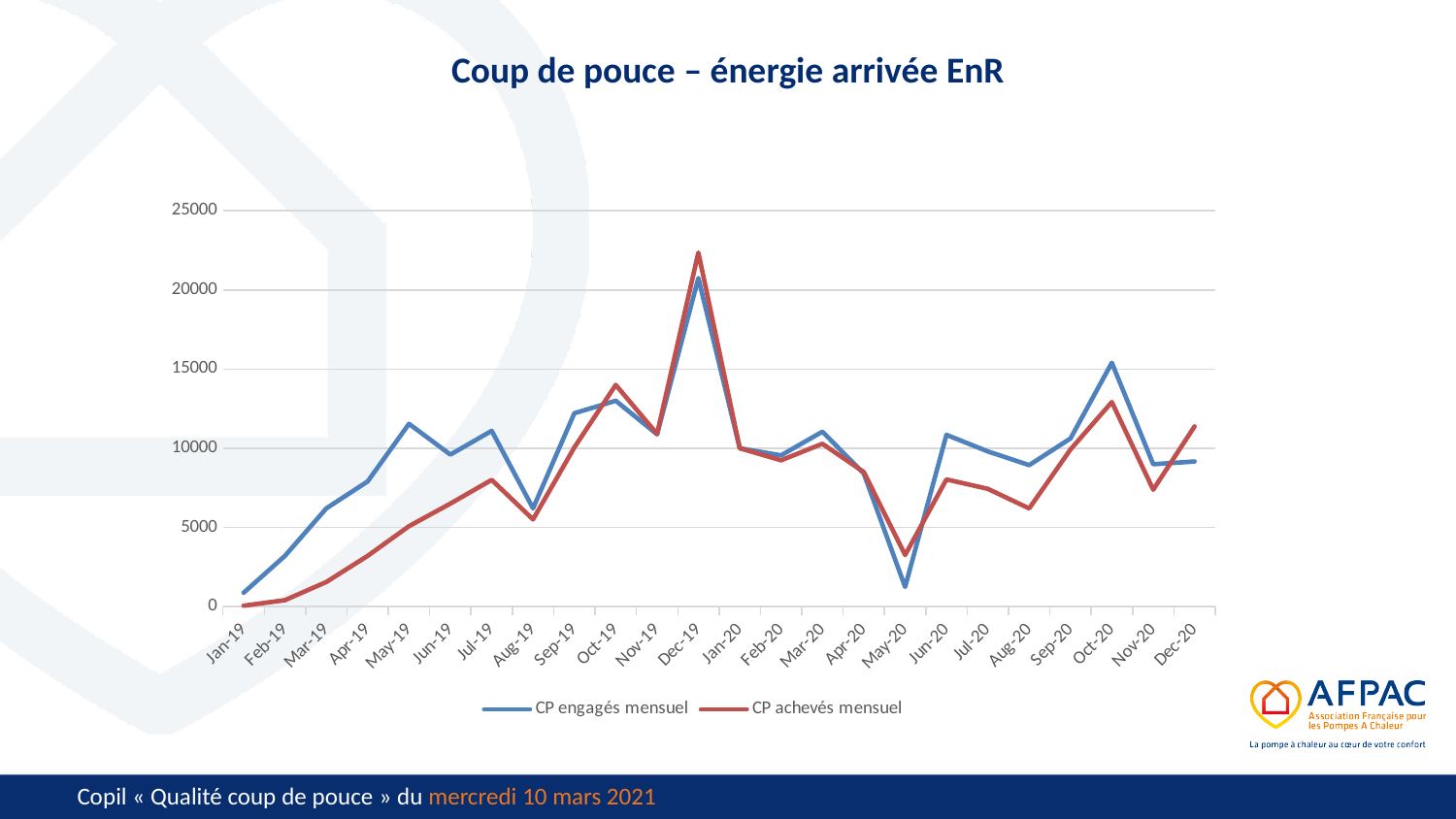
How many months are plotted along the x axis? 24 In which month is the 'CP achevés mensuel' series at its lowest value? Jan-19 In May-19, which series has the larger value, 'CP engagés mensuel' or 'CP achevés mensuel'? CP engagés mensuel What kind of chart is shown on the slide? line chart In which month does the 'CP achevés mensuel' series reach its highest value? Dec-19 Is the value of 'CP achevés mensuel' in May-20 greater or less than 5000? less Is the value of 'CP engagés mensuel' in Dec-19 greater or less than 20000? greater In which month does the 'CP engagés mensuel' series reach its highest value? Dec-19 How many series does the legend list? 2 What is the title of the chart? Coup de pouce – énergie arrivée EnR Does the 'CP engagés mensuel' series rise or fall from Jan-19 to May-19? rise